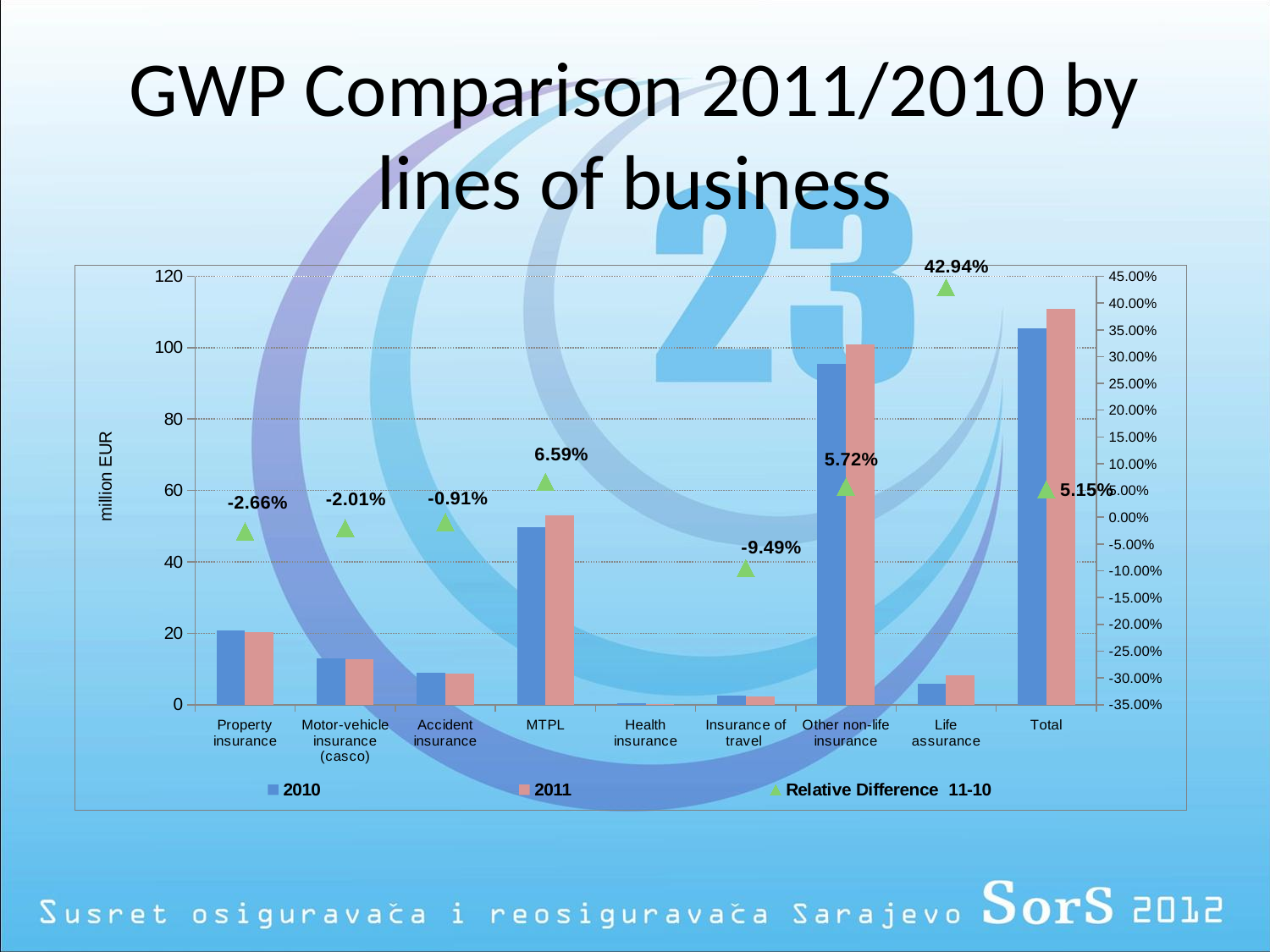
What is the Relative Difference 11-10 value for Insurance of travel? -9.49% What is the Relative Difference 11-10 value for Total? 5.15% How many categories are shown on the x axis? 9 How many series does the legend list? 3 What is the difference in percentage points between the Relative Difference 11-10 for Life assurance and for Total? 37.79 percentage points Which category has the highest Relative Difference 11-10? Life assurance What is the Relative Difference 11-10 value for MTPL? 6.59% Which has a larger Relative Difference 11-10, MTPL or Other non-life insurance? MTPL Is the 2011 value for Life assurance greater or less than 20 million EUR? less What is the Relative Difference 11-10 value for Life assurance? 42.94% Is the 2011 value for Total greater or less than 100 million EUR? greater